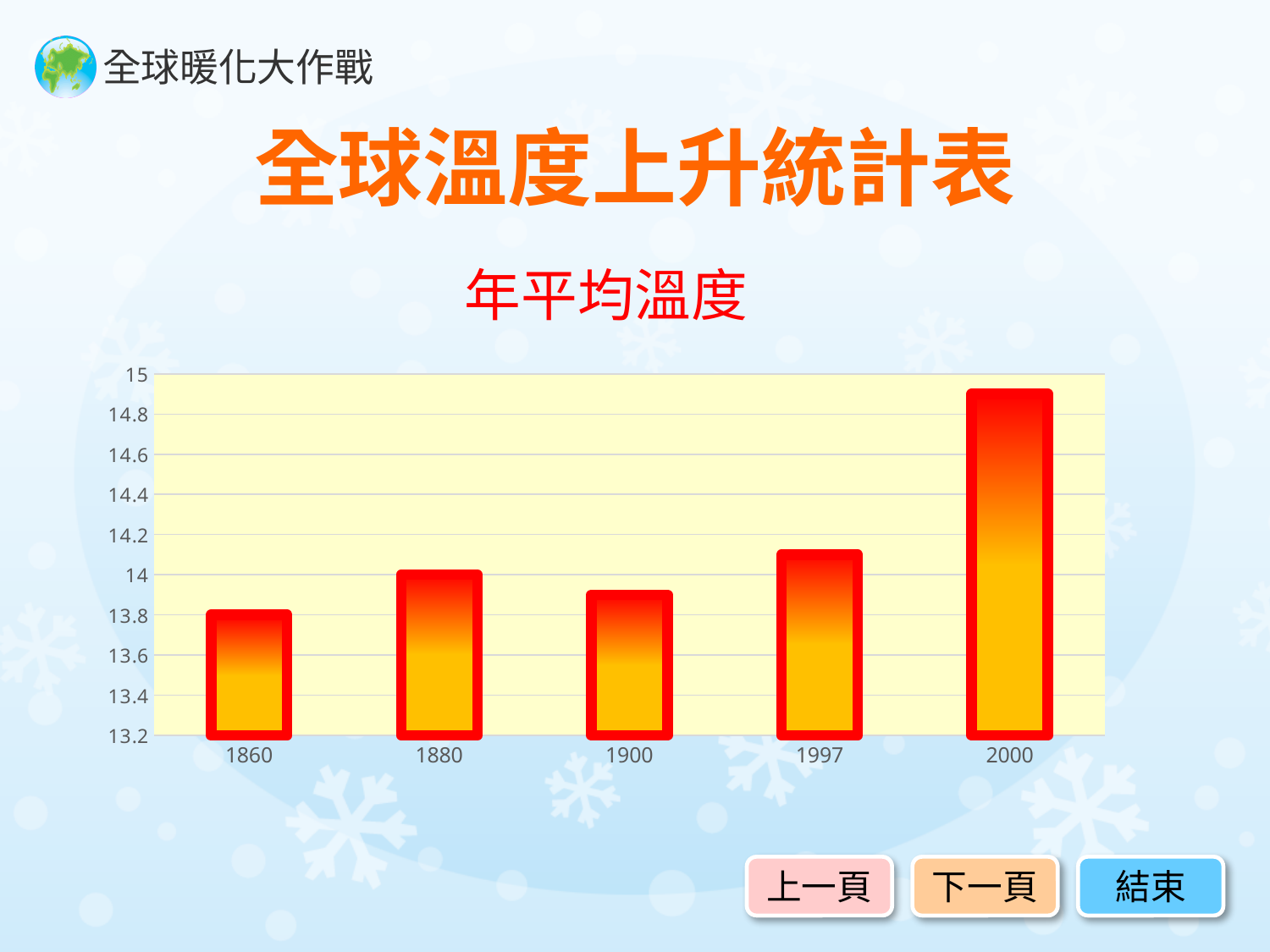
Is the value for 1997 greater or less than 14? greater Which has the larger value, 1997 or 1880? 1997 What kind of chart is shown on the slide? bar chart Overall, do the values rise or fall from 1860 to 2000? rise How many years (categories) are plotted in the chart? 5 Is the value for 2000 greater or less than 14.8? greater Which year has the highest average temperature in the chart? 2000 Which year has the lowest average temperature in the chart? 1860 Is the value for 1900 greater or less than 14? less Which has the larger value, 1880 or 1900? 1880 What is the title of the chart? 年平均溫度